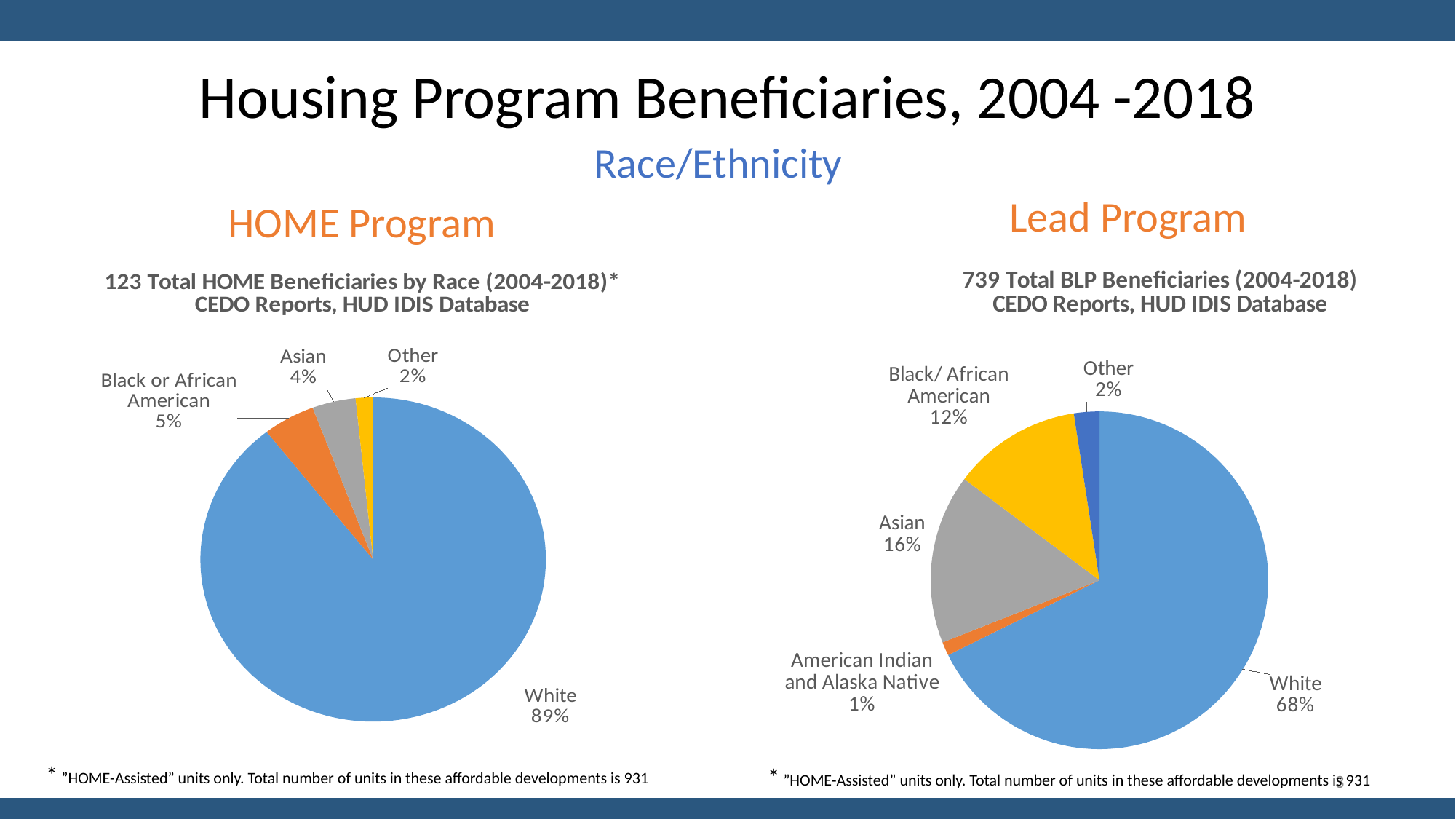
How many categories are shown in the HOME Program pie chart? 4 In the HOME Program pie chart, what share of beneficiaries is Black or African American? 5% How many categories are shown in the Lead Program pie chart? 5 In the HOME Program pie chart, what share of beneficiaries is White? 89% What is the title of the Lead Program chart? 739 Total BLP Beneficiaries (2004-2018) CEDO Reports, HUD IDIS Database What type of chart is used for the HOME Program? Pie chart In the Lead Program pie chart, which is larger: the Black/ African American share or the Asian share? Asian In the HOME Program pie chart, which category has the smallest share? Other In the Lead Program pie chart, which category has the largest share? White In the Lead Program pie chart, what is the difference between the White share and the Asian share? 52% In the Lead Program pie chart, what share of beneficiaries is Asian? 16% In the Lead Program pie chart, what share of beneficiaries is American Indian and Alaska Native? 1%